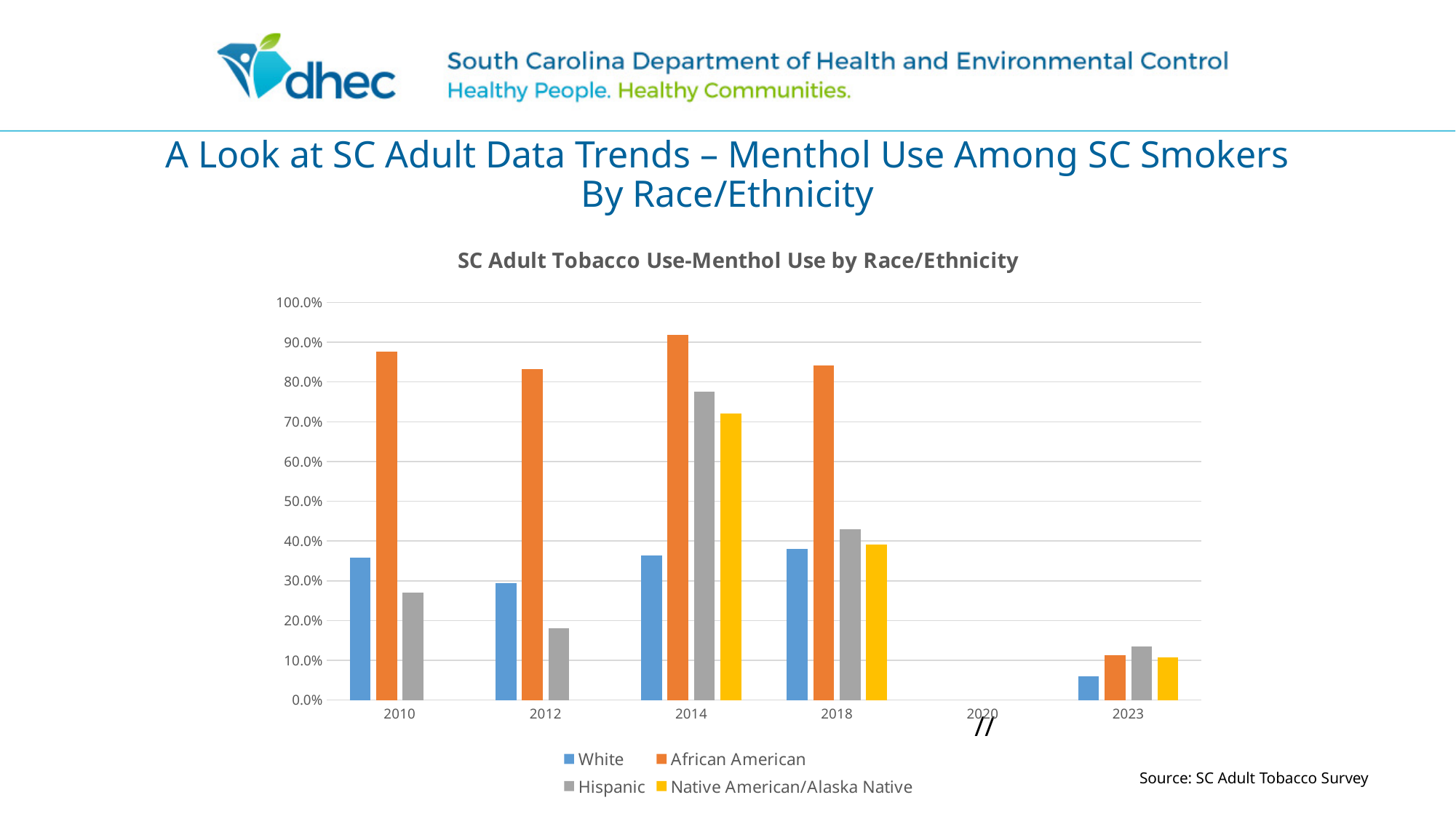
Which race/ethnicity group has the highest menthol use in 2014? African American How many year categories are shown on the x axis? 6 In 2018, which is larger: the value for Hispanic or the value for White? Hispanic Does the value for African American rise or fall from 2018 to 2023? fall Which race/ethnicity group has the lowest menthol use in 2023? White Is the value for Native American/Alaska Native in 2014 greater or less than 60.0%? greater Is the value for Hispanic in 2012 greater or less than 20.0%? less What is the title of the chart? SC Adult Tobacco Use-Menthol Use by Race/Ethnicity Is the value for African American in 2014 greater or less than 90.0%? greater What kind of chart is shown on the slide? bar chart How many series does the legend list? 4